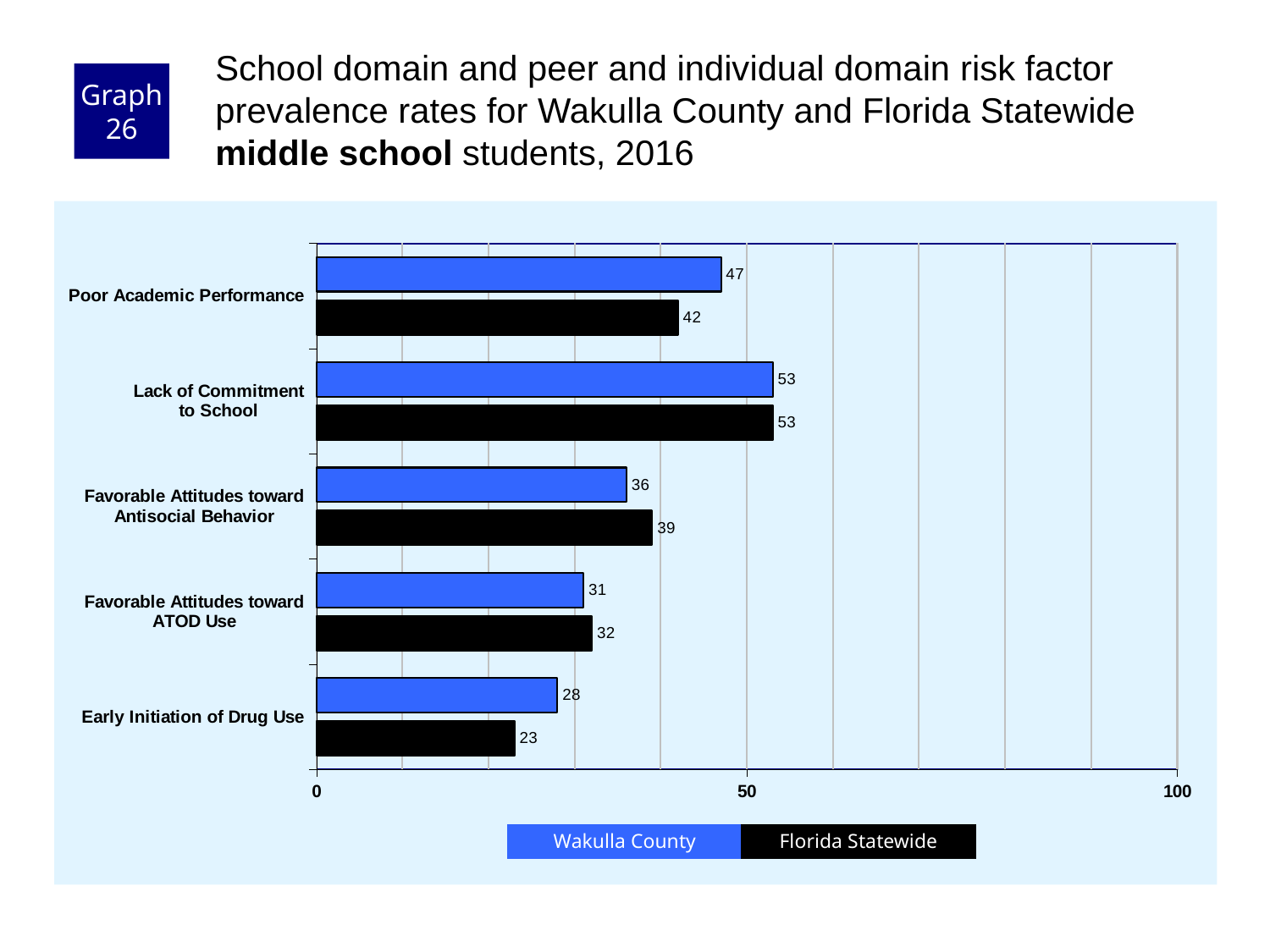
How many series does the legend list? 2 What is the Florida Statewide value for Favorable Attitudes toward Antisocial Behavior? 39 What is the Wakulla County value for Poor Academic Performance? 47 What is the Florida Statewide value for Early Initiation of Drug Use? 23 Which is larger for Favorable Attitudes toward Antisocial Behavior: the Wakulla County value or the Florida Statewide value? Florida Statewide How many risk factor categories are shown on the chart? 5 Is the Wakulla County value for Lack of Commitment to School greater or less than 50? greater What kind of chart is shown on the slide? bar chart What is the difference between the Wakulla County and Florida Statewide values for Early Initiation of Drug Use? 5 Which risk factor has the highest Wakulla County value? Lack of Commitment to School What is the difference between the Wakulla County and Florida Statewide values for Poor Academic Performance? 5 Which risk factor has the lowest Florida Statewide value? Early Initiation of Drug Use